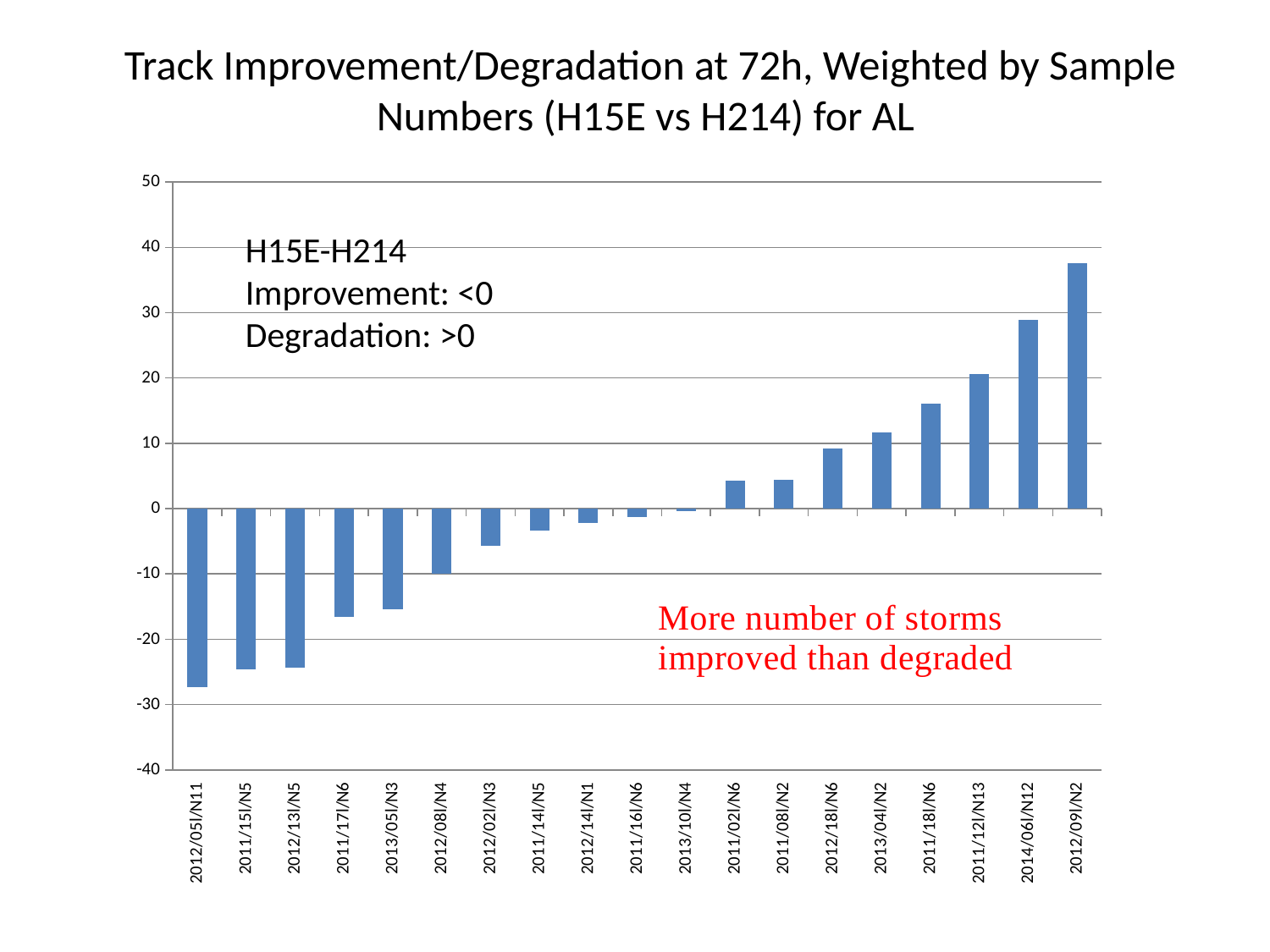
Which is larger, the value for 2012/05l/N11 or the value for 2011/17l/N6? 2011/17l/N6 How many storm categories are plotted along the x axis? 19 Is the value for 2012/09l/N2 greater or less than 30? greater Which category has the highest value? 2012/09l/N2 Is the value for 2011/17l/N6 greater or less than -10? less Which category has the lowest value? 2012/05l/N11 Is the value for 2012/05l/N11 greater or less than -20? less Do the values rise or fall moving from left to right along the x axis? rise According to the text on the chart, does a value below 0 indicate improvement or degradation? Improvement What kind of chart is shown on the slide? bar chart Which is larger, the value for 2014/06l/N12 or the value for 2011/12l/N13? 2014/06l/N12